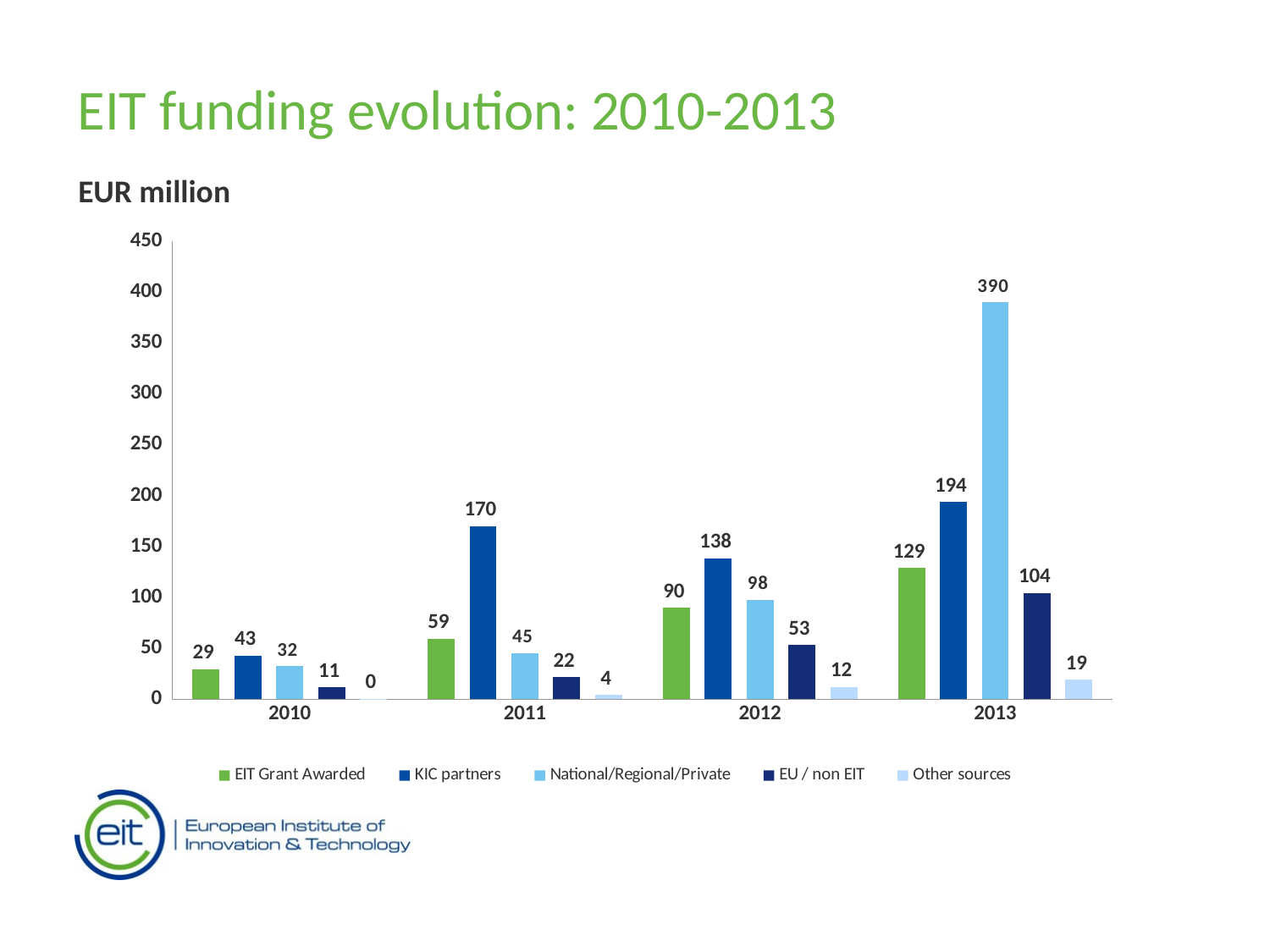
Which is larger in 2012: KIC partners or EIT Grant Awarded? KIC partners Which series has the lowest value in 2011? Other sources What is the value for National/Regional/Private in 2011? 45 Which year has the highest value for EIT Grant Awarded? 2013 What kind of chart is shown on the slide? Bar chart How many years are shown on the x axis? 4 Do the KIC partners values rise or fall from 2010 to 2013? Neither consistently; they rise from 43 to 170, fall to 138, then rise to 194 How many series does the legend list? 5 What is the value for Other sources in 2010? 0 What is the value for KIC partners in 2013? 194 What is the difference between the National/Regional/Private values for 2013 and 2012? 292 What is the value for EU / non EIT in 2012? 53